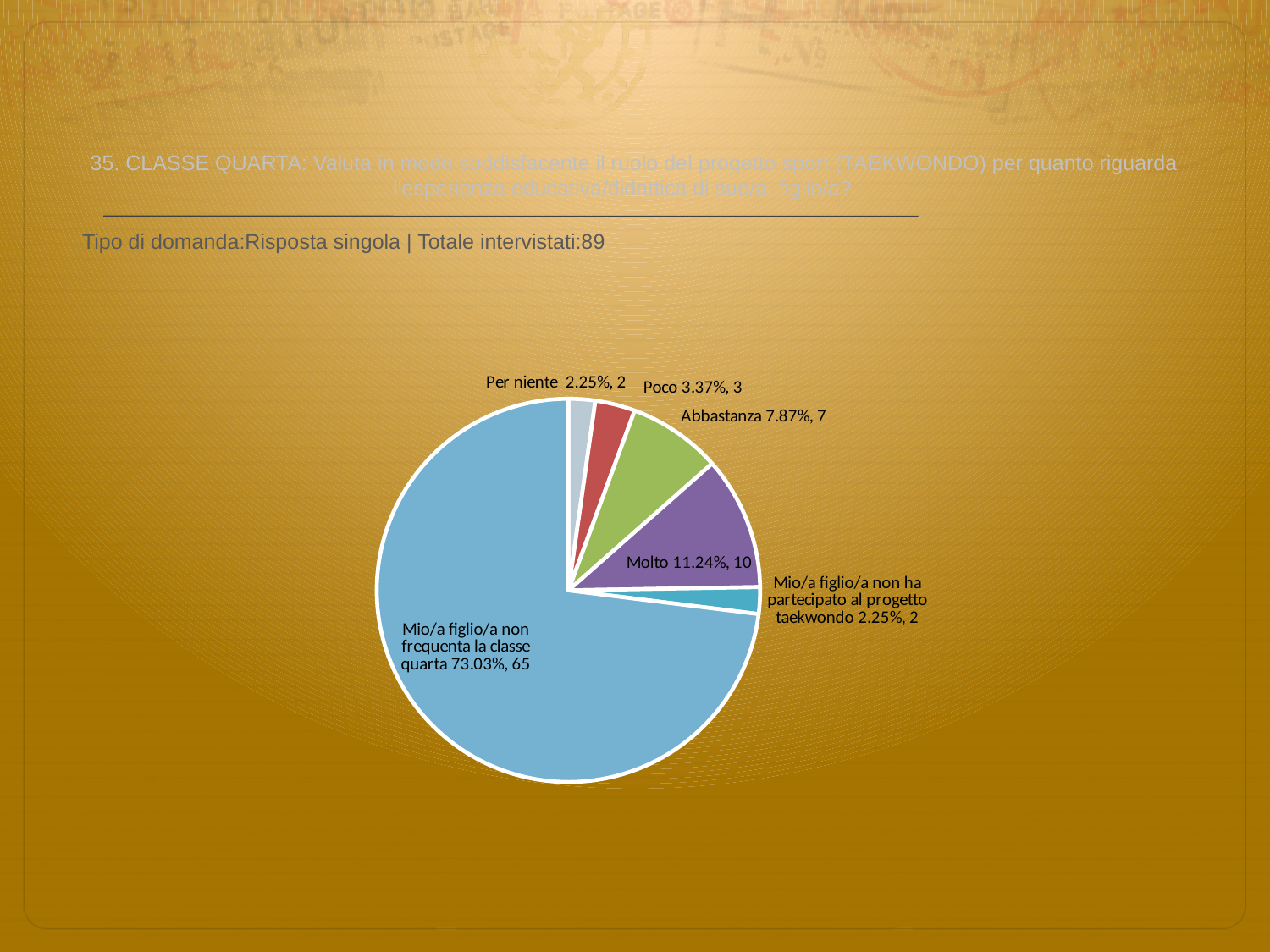
What percentage share does the 'Mio/a figlio/a non frequenta la classe quarta' slice have? 73.03% What is the total number of respondents stated on the slide? 89 How many respondents answered 'Poco'? 3 Which category has the largest slice of the pie? Mio/a figlio/a non frequenta la classe quarta How many respondents answered 'Mio/a figlio/a non ha partecipato al progetto taekwondo'? 2 What percentage share does the 'Molto' slice have? 11.24% How many respondents answered 'Abbastanza'? 7 Which has more respondents, 'Poco' or 'Per niente'? Poco What kind of chart is shown on the slide? pie chart What is the difference in count between 'Molto' and 'Abbastanza'? 3 What percentage share does the 'Per niente' slice have? 2.25% How many slices does the pie chart have? 6